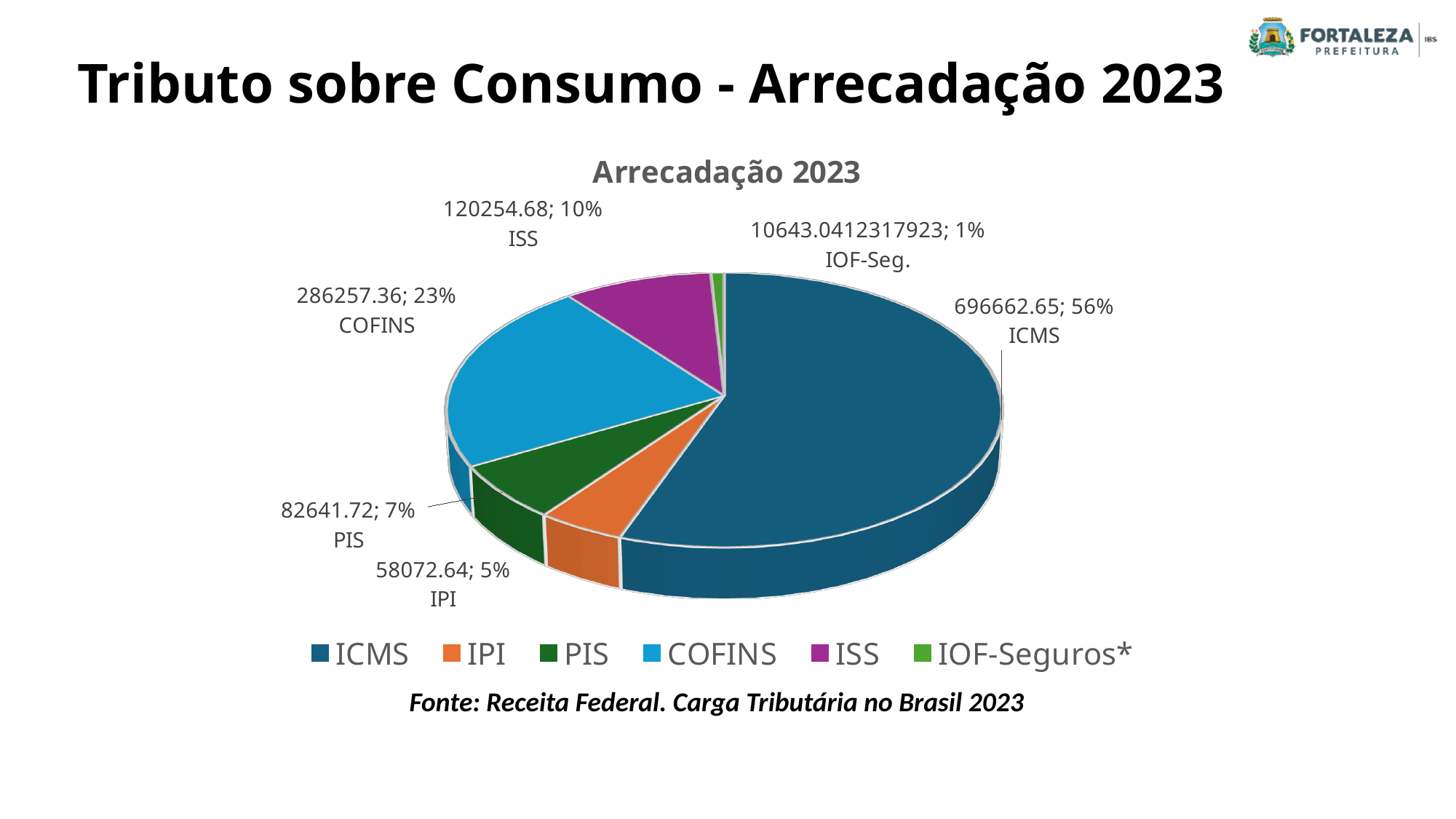
What is the difference between the values for COFINS and ISS? 166002.68 How many entries does the legend list? 6 Which category has the smallest slice? IOF-Seg. What share of the pie does ISS represent? 10% What is the value shown for ICMS? 696662.65 Which is larger, the value for PIS or the value for IPI? PIS What is the value shown for COFINS? 286257.36 Which category has the largest slice? ICMS What is the title of the chart? Arrecadação 2023 How many slices does the pie chart have? 6 What share of the pie does IPI represent? 5% What kind of chart is shown on the slide? Pie chart